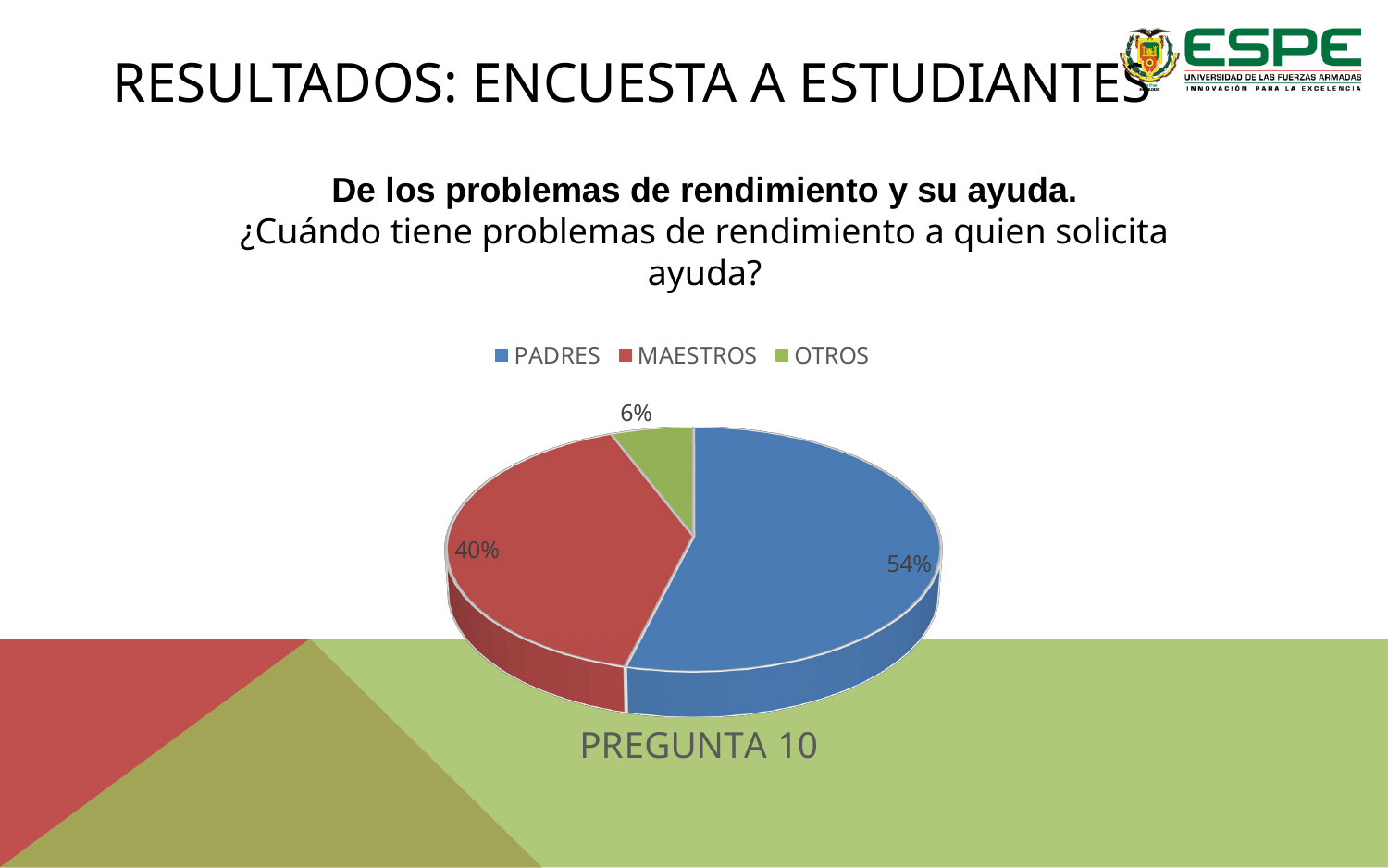
What is the difference in percentage points between MAESTROS and OTROS? 34 What percentage of the pie chart corresponds to OTROS? 6% Which category has the largest share of the pie chart? PADRES What is the title shown below the pie chart? PREGUNTA 10 What percentage of the pie chart corresponds to PADRES? 54% What is the difference in percentage points between PADRES and MAESTROS? 14 How many entries does the legend list? 3 What percentage of the pie chart corresponds to MAESTROS? 40% What kind of chart is shown on the slide? Pie chart Which category has the smallest share of the pie chart? OTROS Which is larger, the share for MAESTROS or the share for OTROS? MAESTROS How many categories does the pie chart show? 3